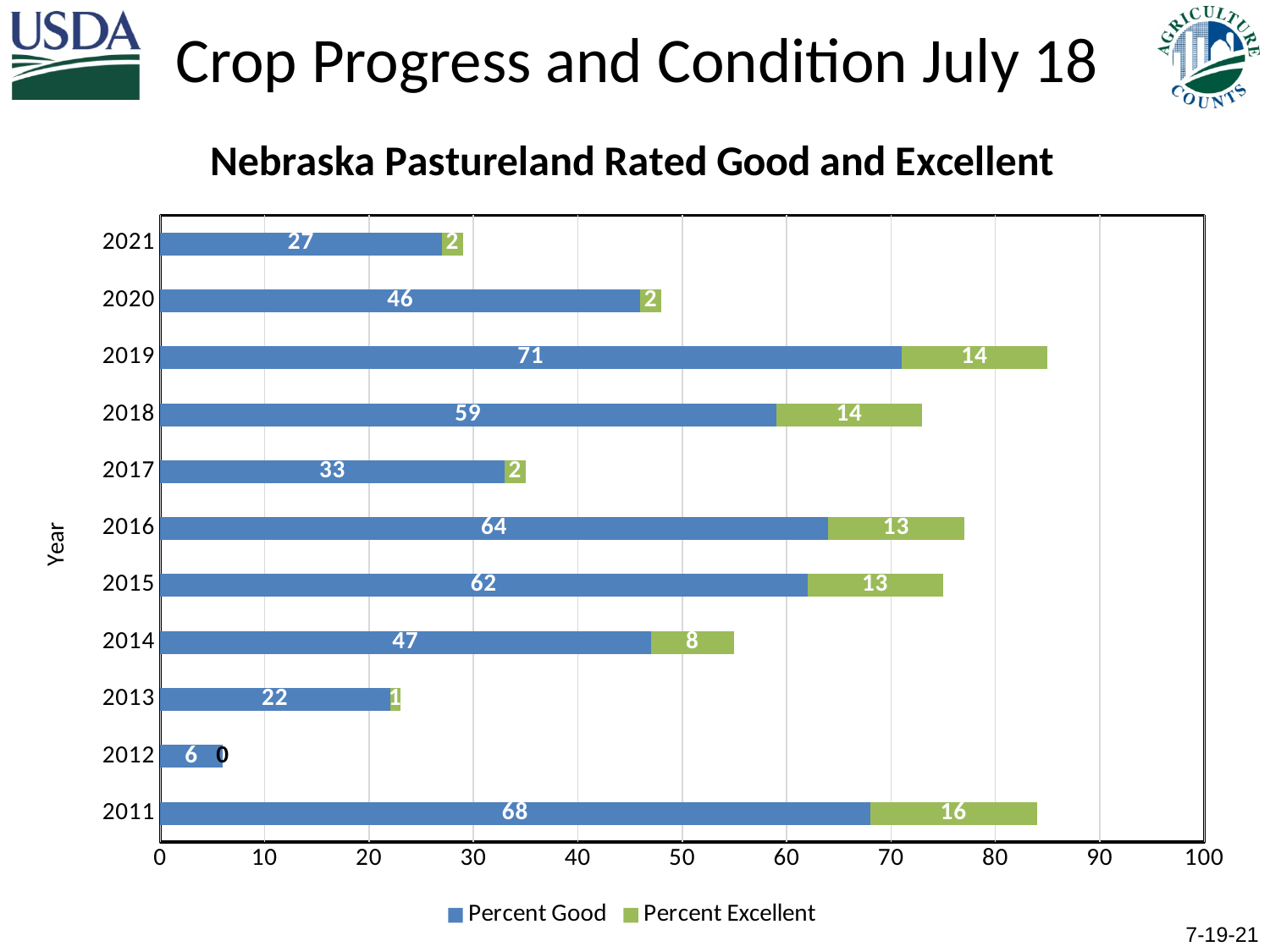
What kind of chart is shown on the slide? Stacked bar chart What is the difference between the Percent Good values for 2019 and 2020? 25 Which year has the lowest Percent Good value? 2012 What is the Percent Excellent value for 2011? 16 What is the total of the stacked bar for 2018? 73 What is the total of the stacked bar for 2011? 84 What is the Percent Good value for 2019? 71 Which year has the larger Percent Good value, 2015 or 2016? 2016 How many series does the legend list? 2 How many years are shown on the chart? 11 Which year has the highest Percent Good value? 2019 What is the title of the chart? Nebraska Pastureland Rated Good and Excellent